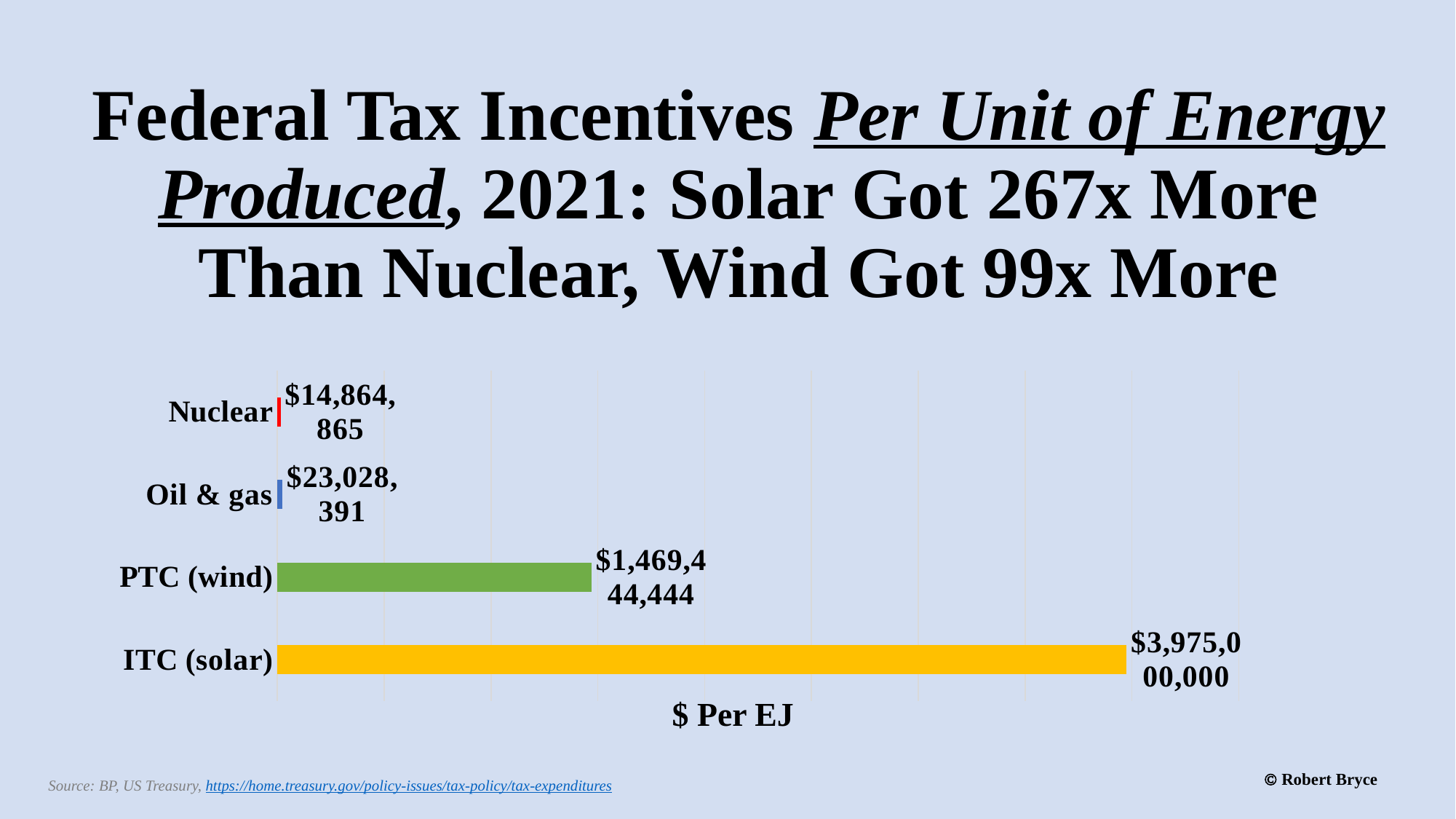
What is the value for ITC (solar)? $3,975,000,000 What is the difference between the values for ITC (solar) and PTC (wind)? $2,505,555,556 What is the value for Oil & gas? $23,028,391 What is the difference between the values for Oil & gas and Nuclear? $8,163,526 What kind of chart is shown on the slide? Bar chart Which category has the lowest value? Nuclear Which is larger, the value for PTC (wind) or the value for Oil & gas? PTC (wind) Which category has the highest value? ITC (solar) What is the value for PTC (wind)? $1,469,444,444 What is the value for Nuclear? $14,864,865 What is the label on the horizontal axis of the chart? $ Per EJ How many categories are shown in the chart? 4